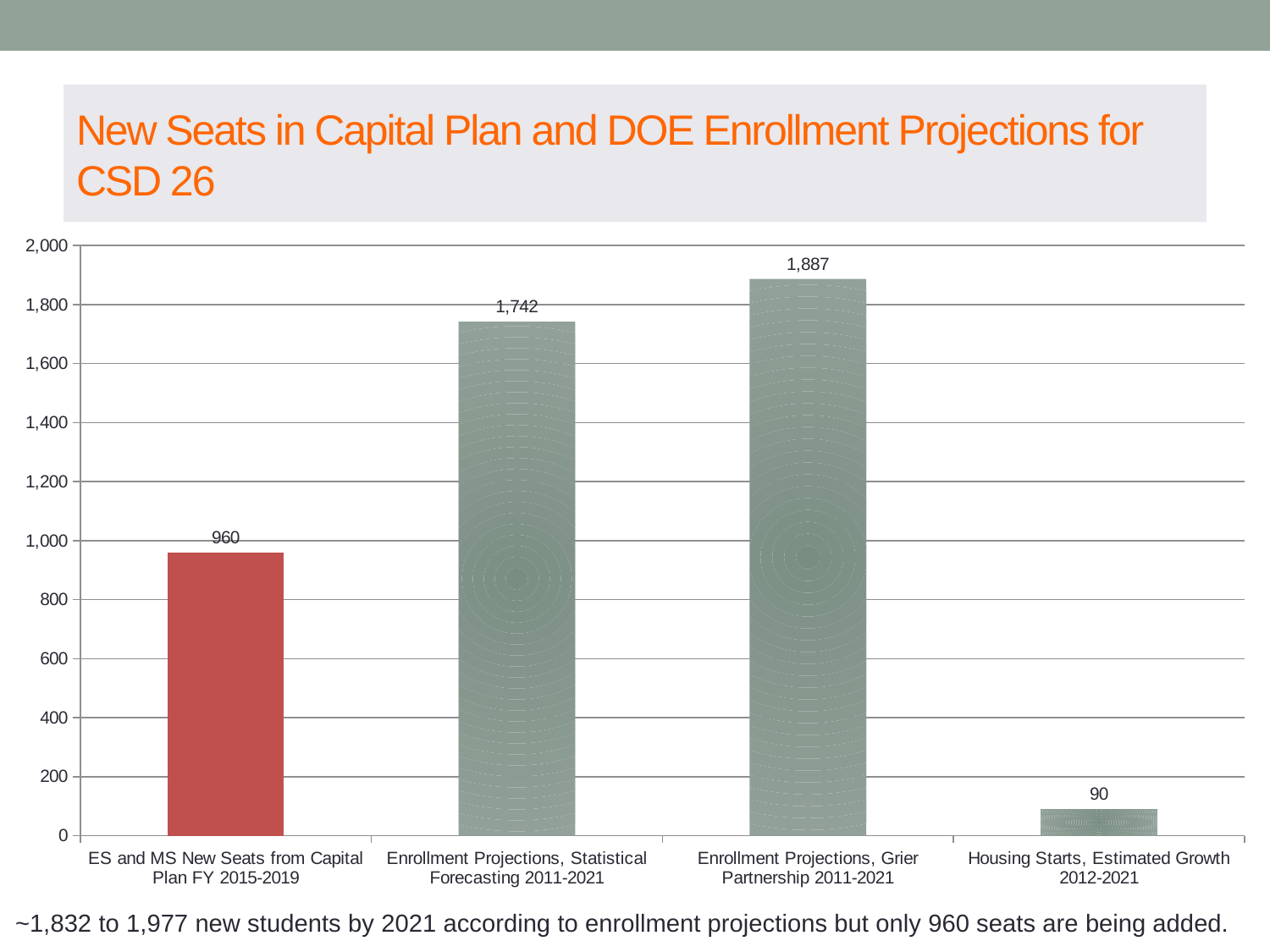
What kind of chart is shown on the slide? Bar chart What is the difference between the Grier Partnership enrollment projection and the Statistical Forecasting enrollment projection? 145 Which category has the highest value? Enrollment Projections, Grier Partnership 2011-2021 Which category has the lowest value? Housing Starts, Estimated Growth 2012-2021 What is the value for Housing Starts, Estimated Growth 2012-2021? 90 What is the value for Enrollment Projections, Statistical Forecasting 2011-2021? 1,742 How many categories are shown in the chart? 4 Which is larger: ES and MS New Seats from Capital Plan FY 2015-2019 or Housing Starts, Estimated Growth 2012-2021? ES and MS New Seats from Capital Plan FY 2015-2019 What is the value for Enrollment Projections, Grier Partnership 2011-2021? 1,887 What is the value for ES and MS New Seats from Capital Plan FY 2015-2019? 960 What is the difference between the Statistical Forecasting enrollment projection and the ES and MS New Seats from Capital Plan FY 2015-2019? 782 What is the title of the chart? New Seats in Capital Plan and DOE Enrollment Projections for CSD 26